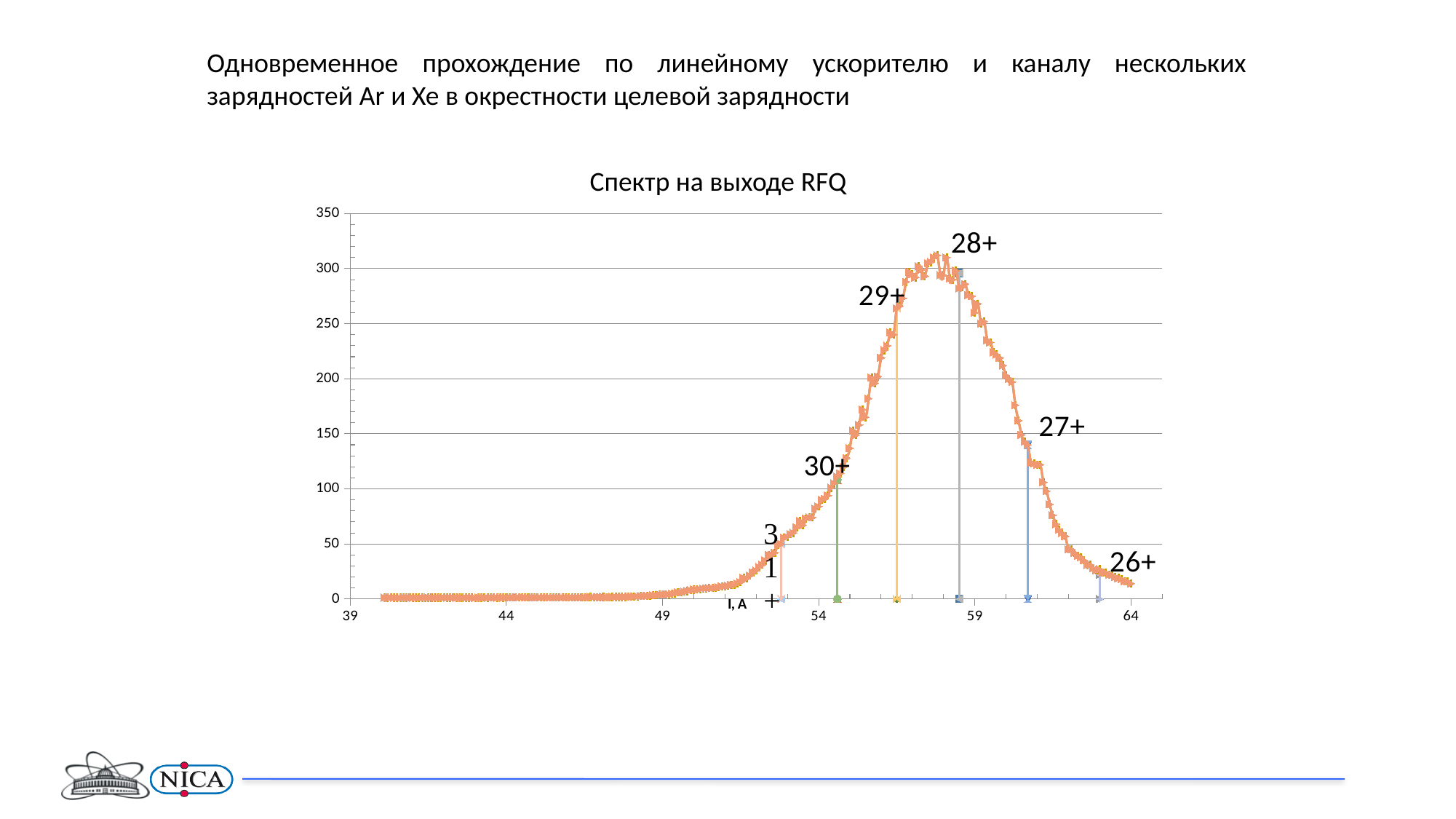
Is the value at the 28+ marker greater or less than 250? greater Is the value at I = 44 A greater or less than 50? less Is the value at the 27+ marker greater or less than 100? greater What is the title of the chart? Спектр на выходе RFQ Does the curve rise or fall between the 28+ marker and the 26+ marker? fall How many charge state labels (such as 28+) are marked on the chart? 6 What label is shown on the x axis of the chart? I, A Which charge state label is placed at the peak of the spectrum? 28+ What kind of chart is shown on the slide? line chart